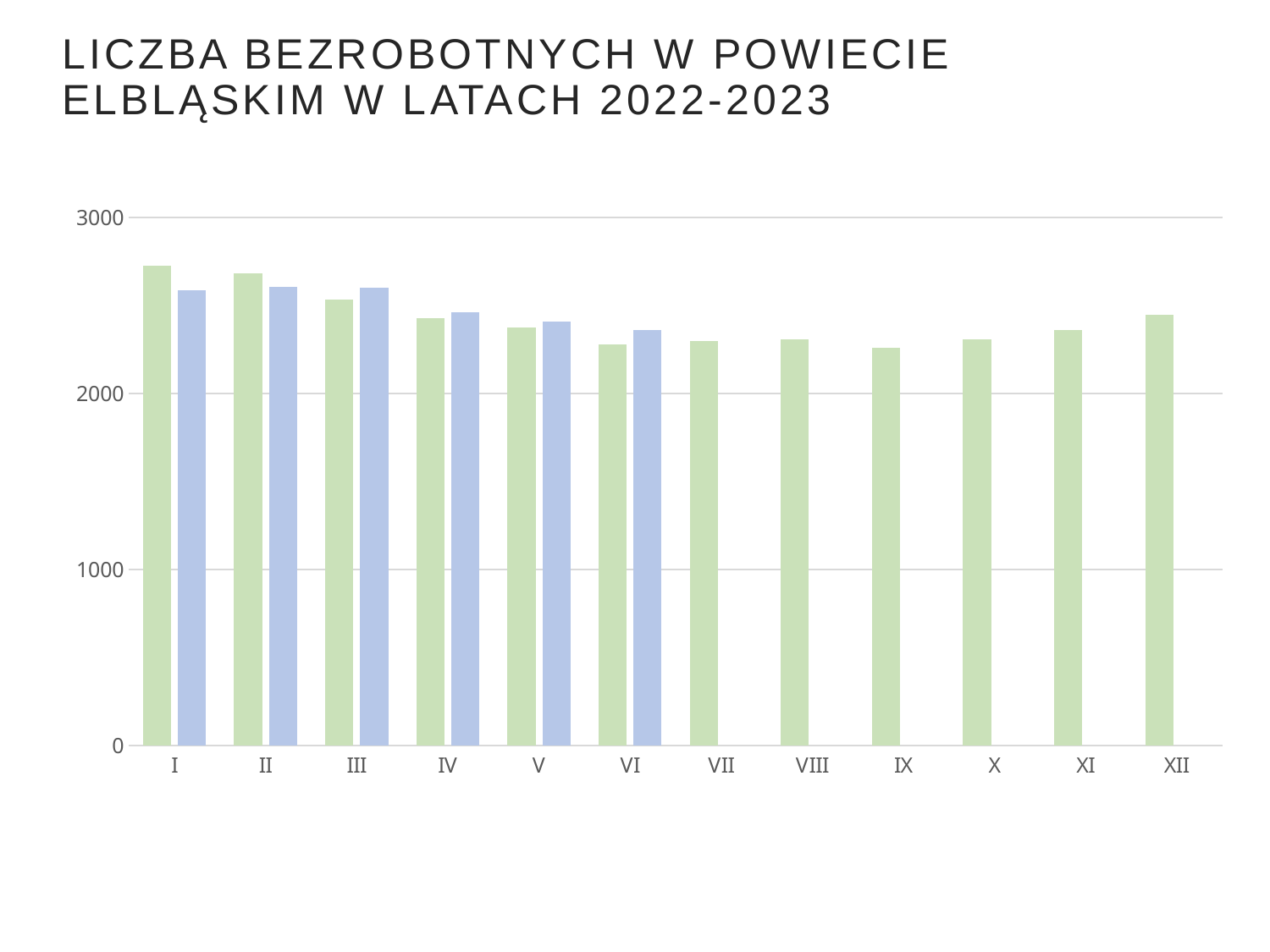
What is the title of the chart? LICZBA BEZROBOTNYCH W POWIECIE ELBLĄSKIM W LATACH 2022-2023 What kind of chart is shown on the slide? bar chart How many months have a blue bar? 6 Among the blue bars, which month has the lowest value? VI How many categories (months) are shown on the x axis? 12 Is the value of the green bar for month IX greater or less than 3000? less Is the value of the green bar for month I greater or less than 2000? greater Which is larger, the green bar for month I or the green bar for month XII? month I Which is larger, the green bar or the blue bar for month I? the green bar Is the value of the blue bar for month VI greater or less than 2000? greater Which is larger, the green bar or the blue bar for month VI? the blue bar Do the green bars rise or fall from month I to month VI? fall